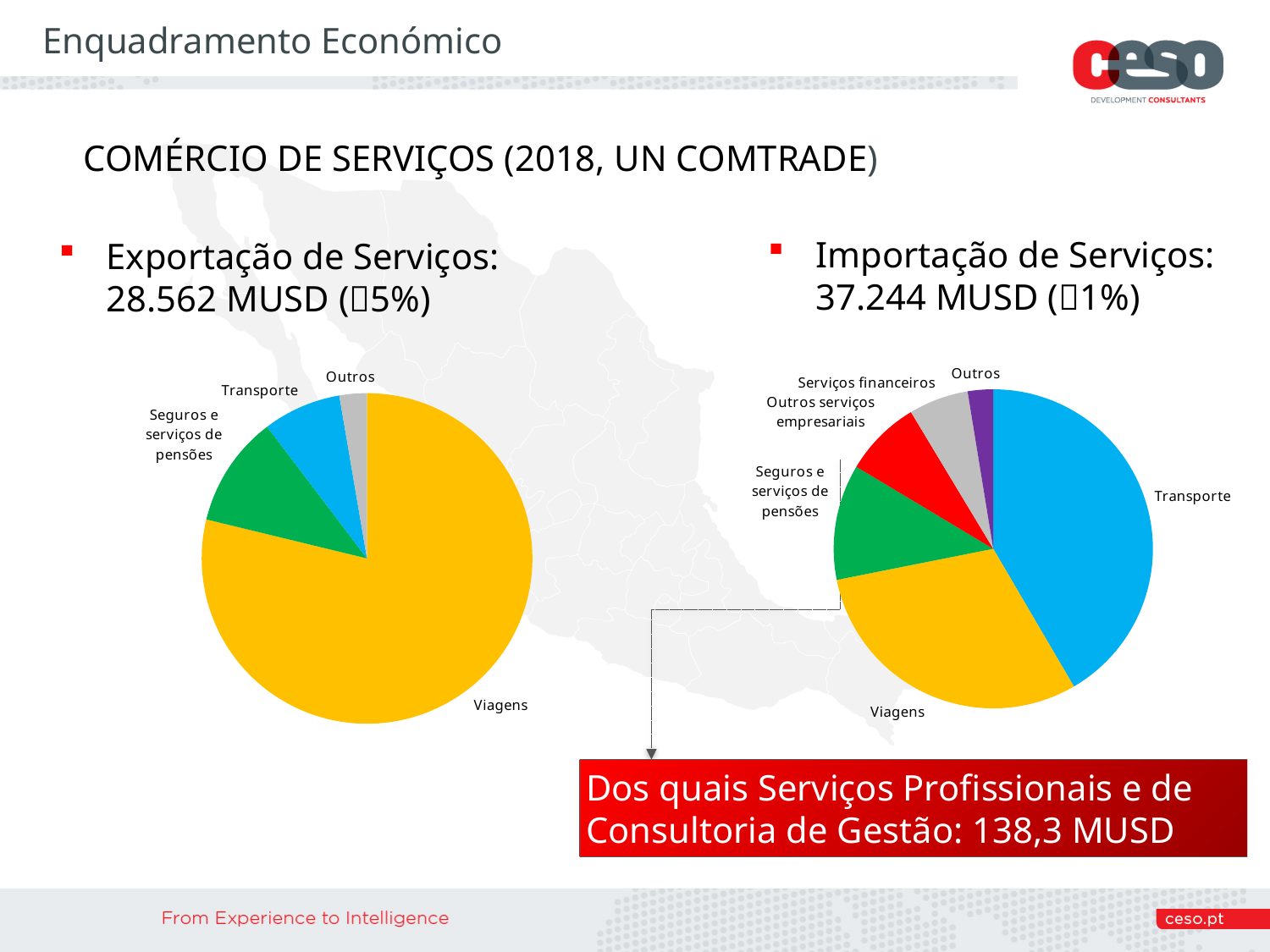
What kind of chart is used for the Exportação de Serviços chart on the left? Pie chart In the Importação de Serviços pie chart on the right, which category has the smallest share? Outros In the Importação de Serviços pie chart on the right, how many slices are there? 6 In the Exportação de Serviços pie chart on the left, which is larger: Seguros e serviços de pensões or Transporte? Seguros e serviços de pensões In the Importação de Serviços pie chart on the right, which category has the largest share? Transporte What kind of chart is used for the Importação de Serviços chart on the right? Pie chart In the Exportação de Serviços pie chart on the left, which category has the smallest share? Outros In the Importação de Serviços pie chart on the right, what colour is the Transporte slice? Blue In the Exportação de Serviços pie chart on the left, which category has the largest share? Viagens In the Importação de Serviços pie chart on the right, which is larger: Viagens or Seguros e serviços de pensões? Viagens In the Exportação de Serviços pie chart on the left, how many slices are there? 4 In the Exportação de Serviços pie chart on the left, what colour is the Viagens slice? Yellow